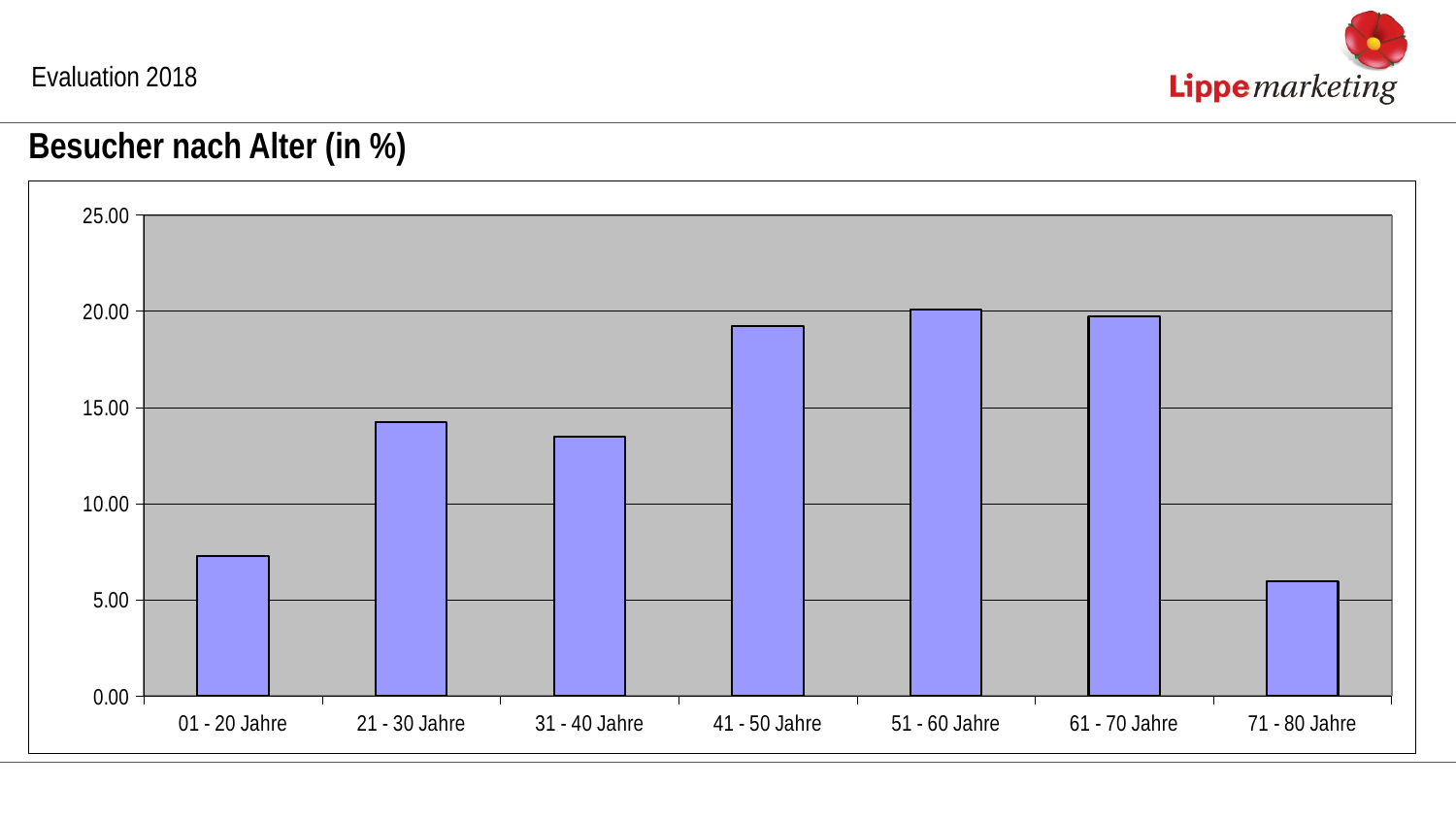
Is the value for 71 - 80 Jahre greater or less than 10.00? less Is the value for 41 - 50 Jahre greater or less than 20.00? less How many age categories are shown on the x axis? 7 What kind of chart is shown on the slide? bar chart Which age category has the lowest value? 71 - 80 Jahre Is the value for 21 - 30 Jahre greater or less than 15.00? less What is the title of the chart? Besucher nach Alter (in %) Which is larger, the value for 21 - 30 Jahre or the value for 31 - 40 Jahre? 21 - 30 Jahre Which is larger, the value for 01 - 20 Jahre or the value for 41 - 50 Jahre? 41 - 50 Jahre Does the value rise or fall from 61 - 70 Jahre to 71 - 80 Jahre? fall